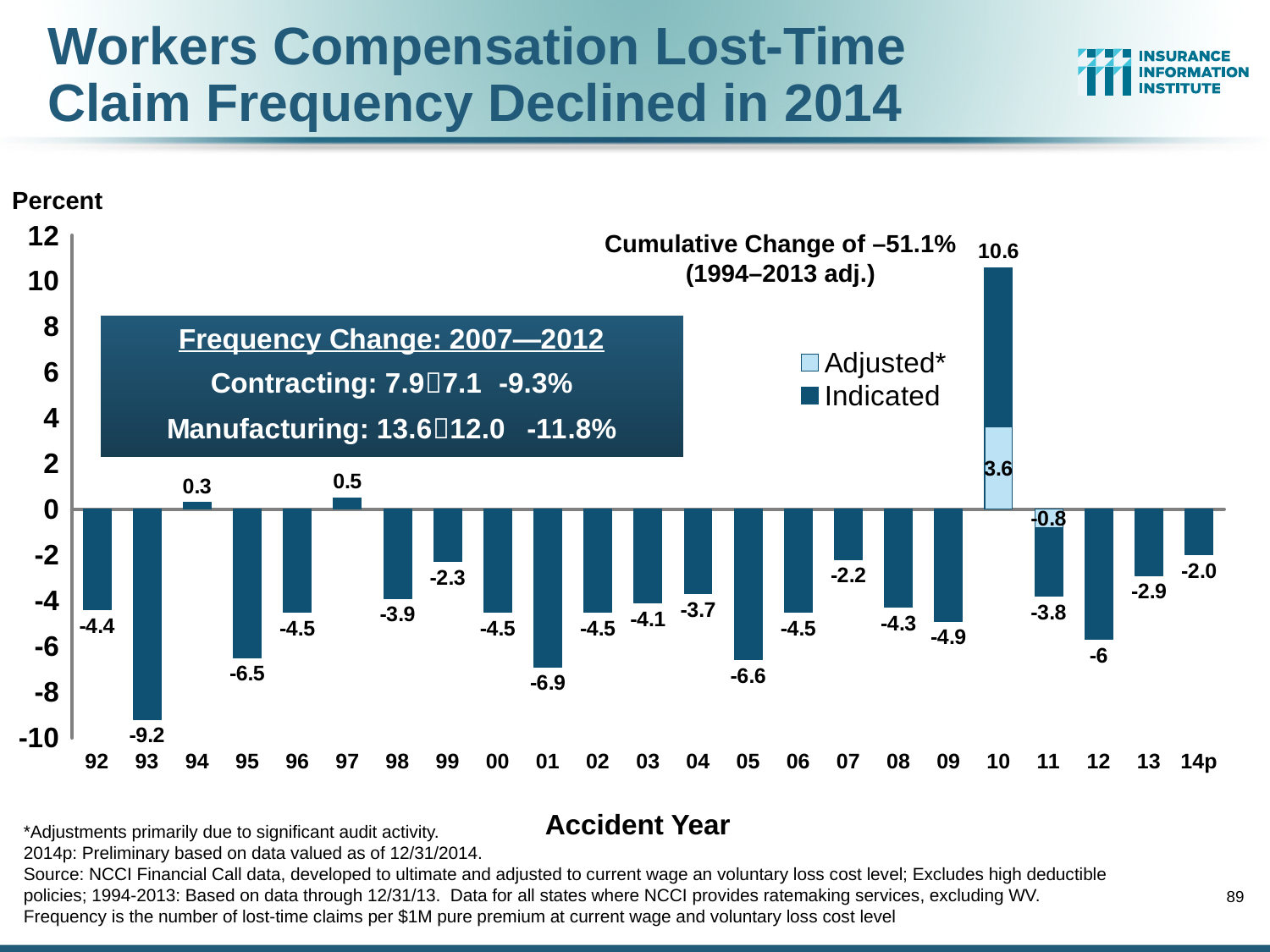
What is the difference between the values for accident years 12 and 13? 3.1 What kind of chart is shown on the slide? Bar chart What is the Indicated value for accident year 10? 10.6 What is the value for accident year 14p? -2.0 Which is larger, the value for accident year 95 or for accident year 98? 98 What is the value for accident year 97? 0.5 Which accident year has the highest value? 10 Which accident year has the lowest value? 93 How many series does the legend list? 2 How many accident years are shown on the x axis? 23 What is the value for accident year 93? -9.2 What is the Adjusted value for accident year 10? 3.6